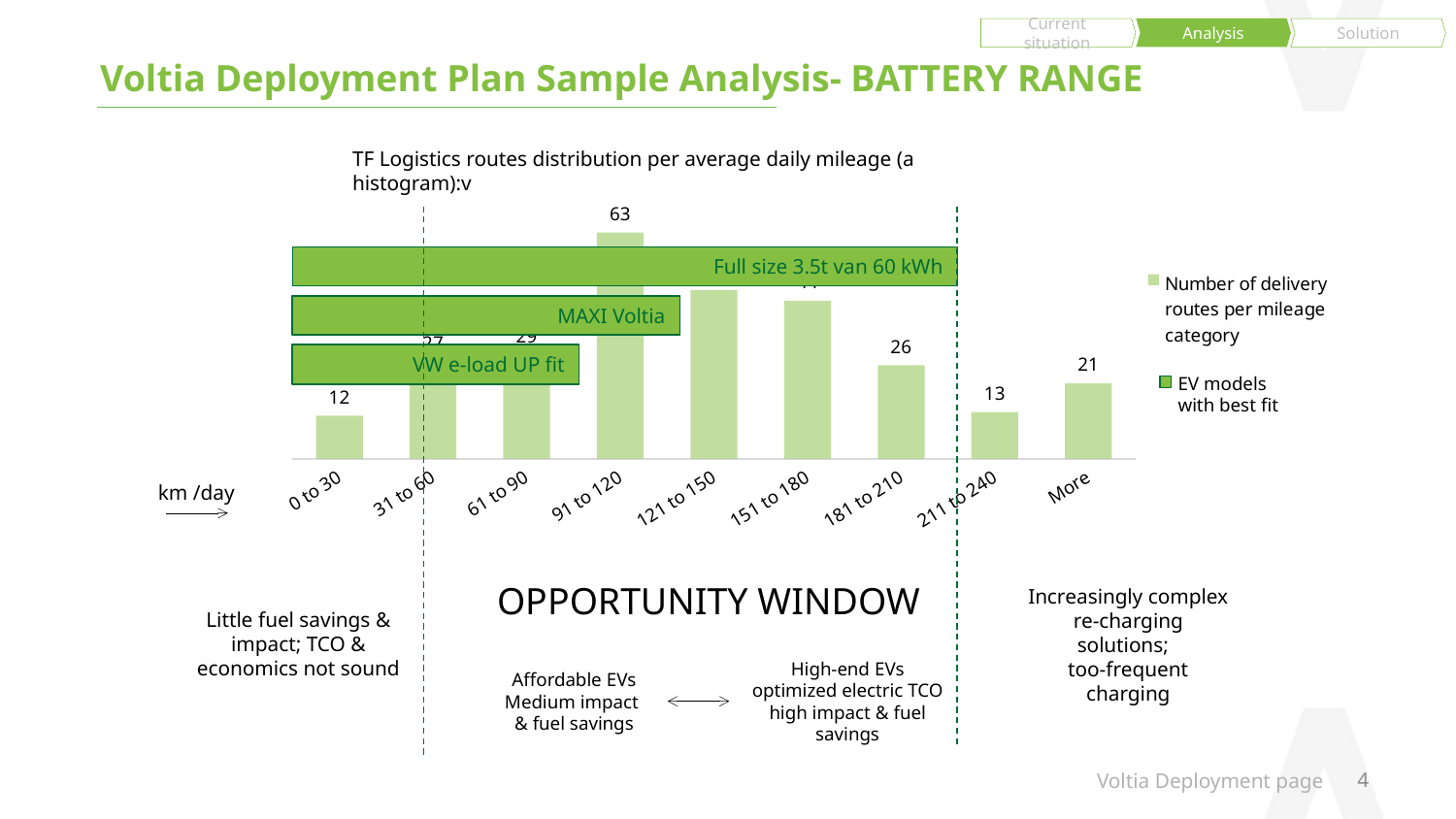
What is the value for the 0 to 30 km/day category? 12 How many mileage categories are shown on the x axis? 9 Which mileage category has the lowest number of delivery routes? 0 to 30 Which has a larger value, 211 to 240 or More? More What kind of chart is shown on the slide? bar chart What is the difference between the values for 181 to 210 and 211 to 240? 13 How many entries does the legend list? 2 What is the value for the 181 to 210 km/day category? 26 What is the value for the 'More' category? 21 How many delivery routes are in the 91 to 120 km/day category? 63 What is the difference between the values for 91 to 120 and 0 to 30? 51 Which mileage category has the highest number of delivery routes? 91 to 120